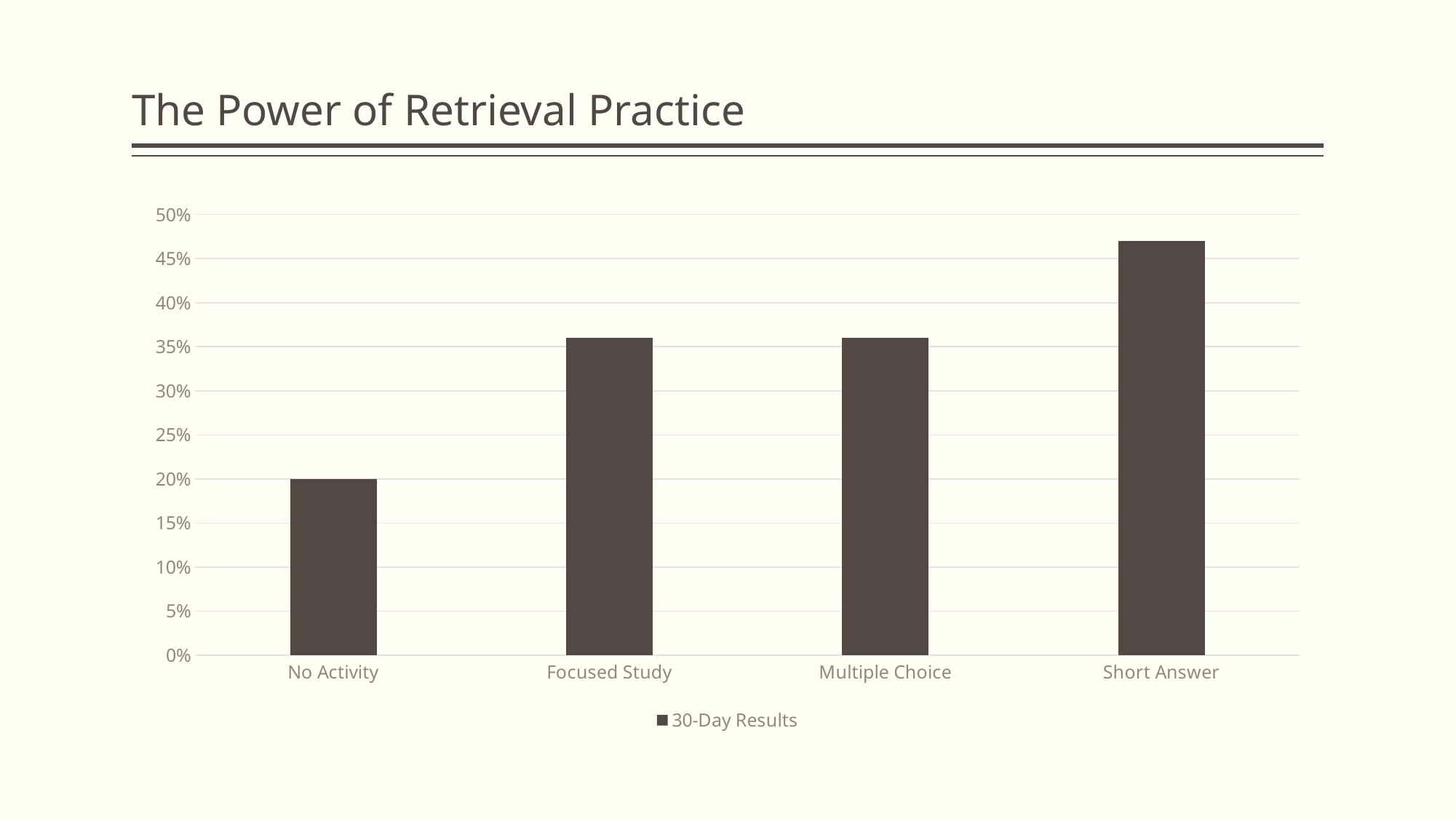
Which category has the highest value? Short Answer What is the name of the series shown in the legend? 30-Day Results What is the value for No Activity? 20% Which category has the lowest value? No Activity Which is larger, the value for Multiple Choice or the value for No Activity? Multiple Choice Is the value for Short Answer greater or less than 45%? greater What kind of chart is shown on the slide? bar chart How many categories are shown on the x axis? 4 Is the value for Focused Study greater or less than 35%? greater How many series does the legend list? 1 Which is larger, the value for Short Answer or the value for Focused Study? Short Answer Is the value for Multiple Choice greater or less than 40%? less